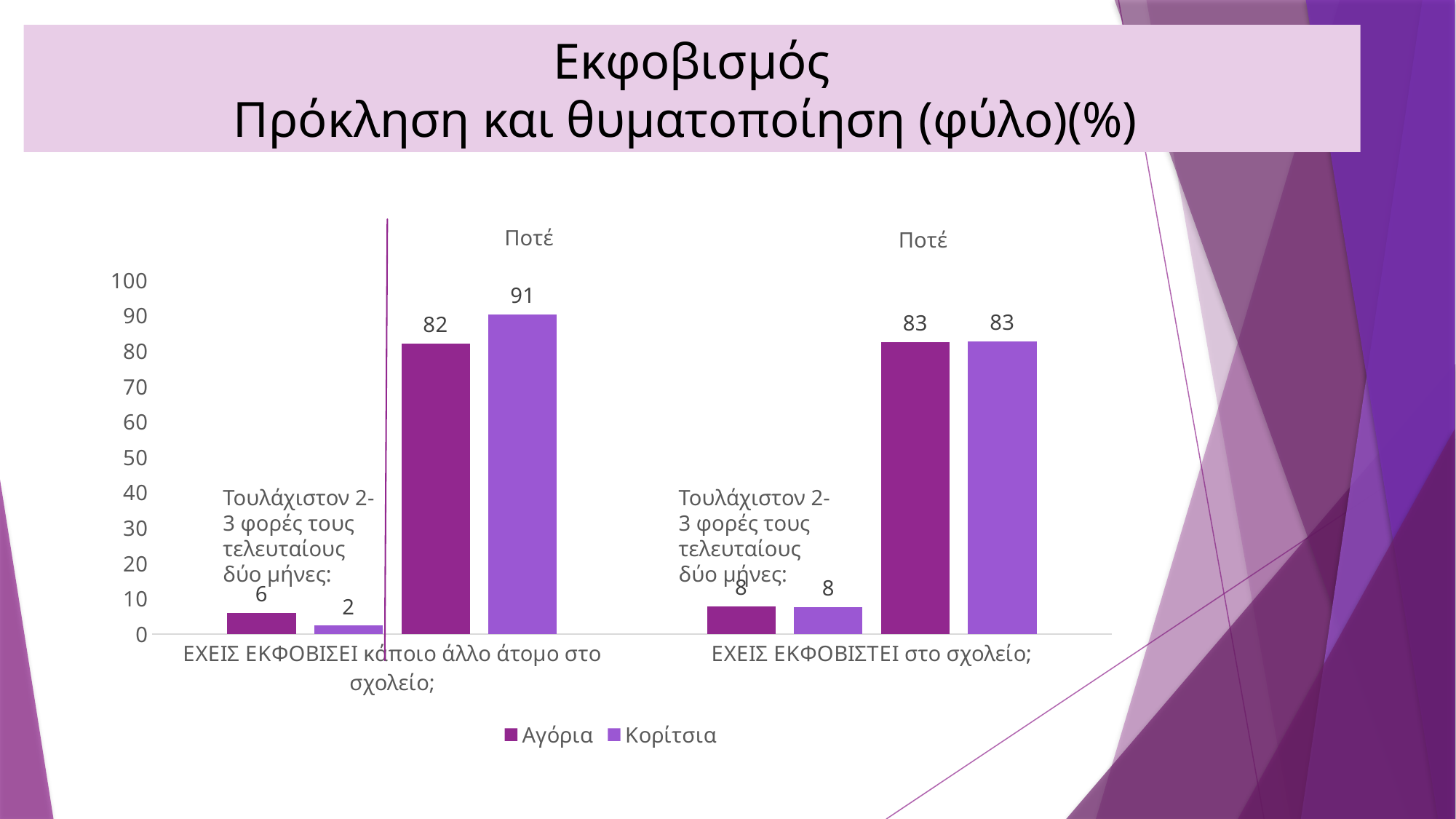
What is the difference between the Κορίτσια and Αγόρια values for 'Ποτέ' under 'ΕΧΕΙΣ ΕΚΦΟΒΙΣΕΙ κάποιο άλλο άτομο στο σχολείο;'? 9 How many series does the legend list? 2 What is the value for Αγόρια who answered 'Ποτέ' to 'ΕΧΕΙΣ ΕΚΦΟΒΙΣΤΕΙ στο σχολείο;'? 83 What is the value for Κορίτσια who answered 'Τουλάχιστον 2-3 φορές τους τελευταίους δύο μήνες' to 'ΕΧΕΙΣ ΕΚΦΟΒΙΣΕΙ κάποιο άλλο άτομο στο σχολείο;'? 2 Which bar has the highest value in the chart? Κορίτσια, Ποτέ, ΕΧΕΙΣ ΕΚΦΟΒΙΣΕΙ κάποιο άλλο άτομο στο σχολείο; (91) What is the value for Αγόρια who answered 'Ποτέ' to 'ΕΧΕΙΣ ΕΚΦΟΒΙΣΕΙ κάποιο άλλο άτομο στο σχολείο;'? 82 What kind of chart is shown on the slide? bar chart What is the difference between the Αγόρια values for 'Ποτέ' and 'Τουλάχιστον 2-3 φορές τους τελευταίους δύο μήνες' under 'ΕΧΕΙΣ ΕΚΦΟΒΙΣΤΕΙ στο σχολείο;'? 75 Which bar has the lowest value in the chart? Κορίτσια, Τουλάχιστον 2-3 φορές τους τελευταίους δύο μήνες, ΕΧΕΙΣ ΕΚΦΟΒΙΣΕΙ κάποιο άλλο άτομο στο σχολείο; (2) What are the two series named in the legend? Αγόρια and Κορίτσια Which is larger for 'Τουλάχιστον 2-3 φορές τους τελευταίους δύο μήνες' under 'ΕΧΕΙΣ ΕΚΦΟΒΙΣΕΙ κάποιο άλλο άτομο στο σχολείο;': Αγόρια or Κορίτσια? Αγόρια What is the value for Κορίτσια who answered 'Ποτέ' to 'ΕΧΕΙΣ ΕΚΦΟΒΙΣΕΙ κάποιο άλλο άτομο στο σχολείο;'? 91